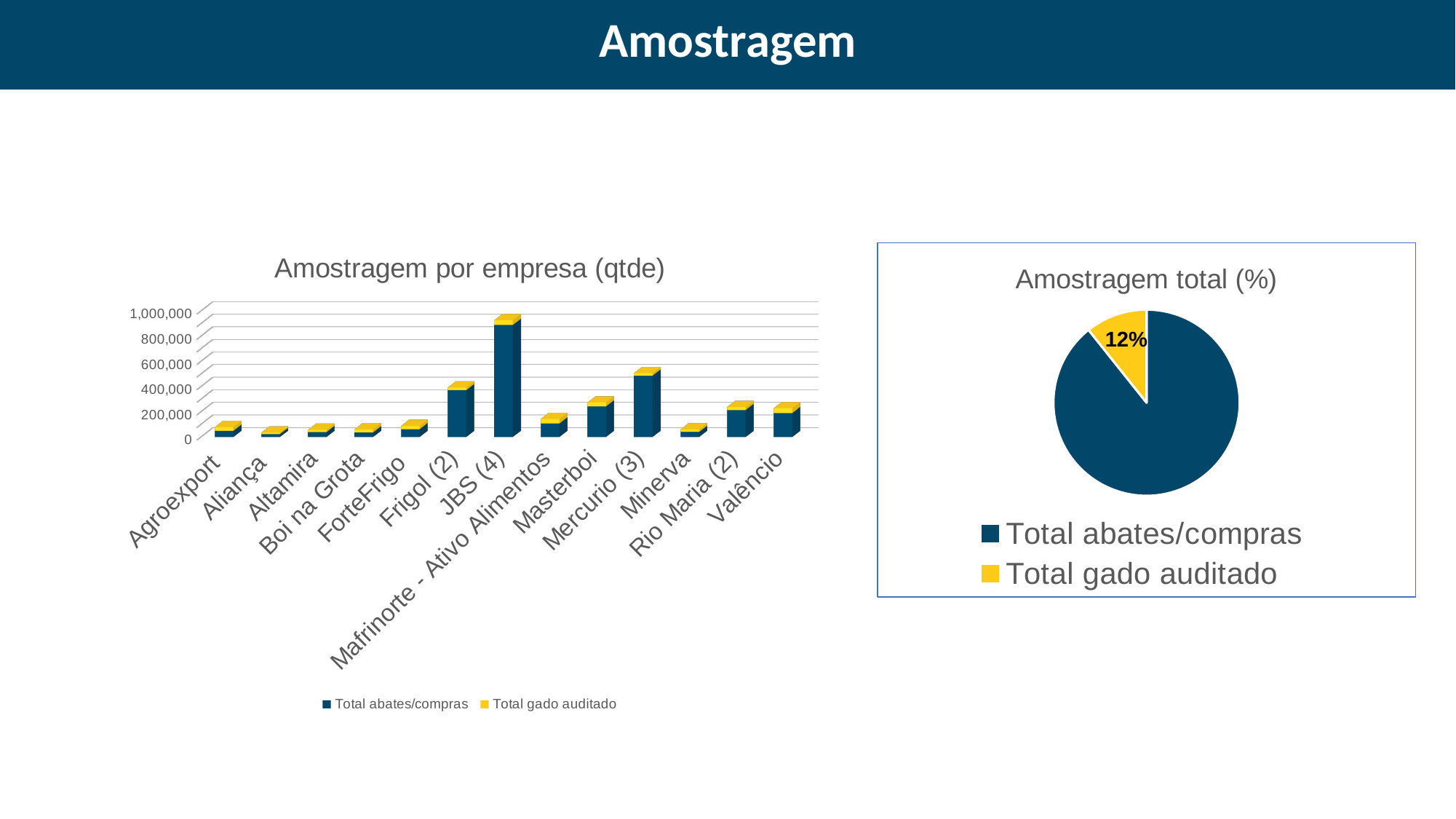
What kind of chart is 'Amostragem por empresa (qtde)'? Bar chart On the chart titled 'Amostragem total (%)', what share of the pie is 'Total gado auditado'? 12% On the chart titled 'Amostragem por empresa (qtde)', which is larger, the bar for JBS (4) or the bar for Mercurio (3)? JBS (4) On the chart titled 'Amostragem por empresa (qtde)', how many series does the legend list? 2 On the chart titled 'Amostragem por empresa (qtde)', which company has the highest bar? JBS (4) On the chart titled 'Amostragem por empresa (qtde)', is the value for JBS (4) greater or less than 800,000? greater On the chart titled 'Amostragem por empresa (qtde)', which is larger, the bar for Frigol (2) or the bar for Masterboi? Frigol (2) On the chart titled 'Amostragem total (%)', which colour represents 'Total gado auditado'? Yellow On the chart titled 'Amostragem por empresa (qtde)', how many companies are shown on the x axis? 13 What kind of chart is 'Amostragem total (%)'? Pie chart On the chart titled 'Amostragem por empresa (qtde)', is the value for Agroexport greater or less than 200,000? less On the chart titled 'Amostragem por empresa (qtde)', is the value for Mercurio (3) greater or less than 400,000? greater